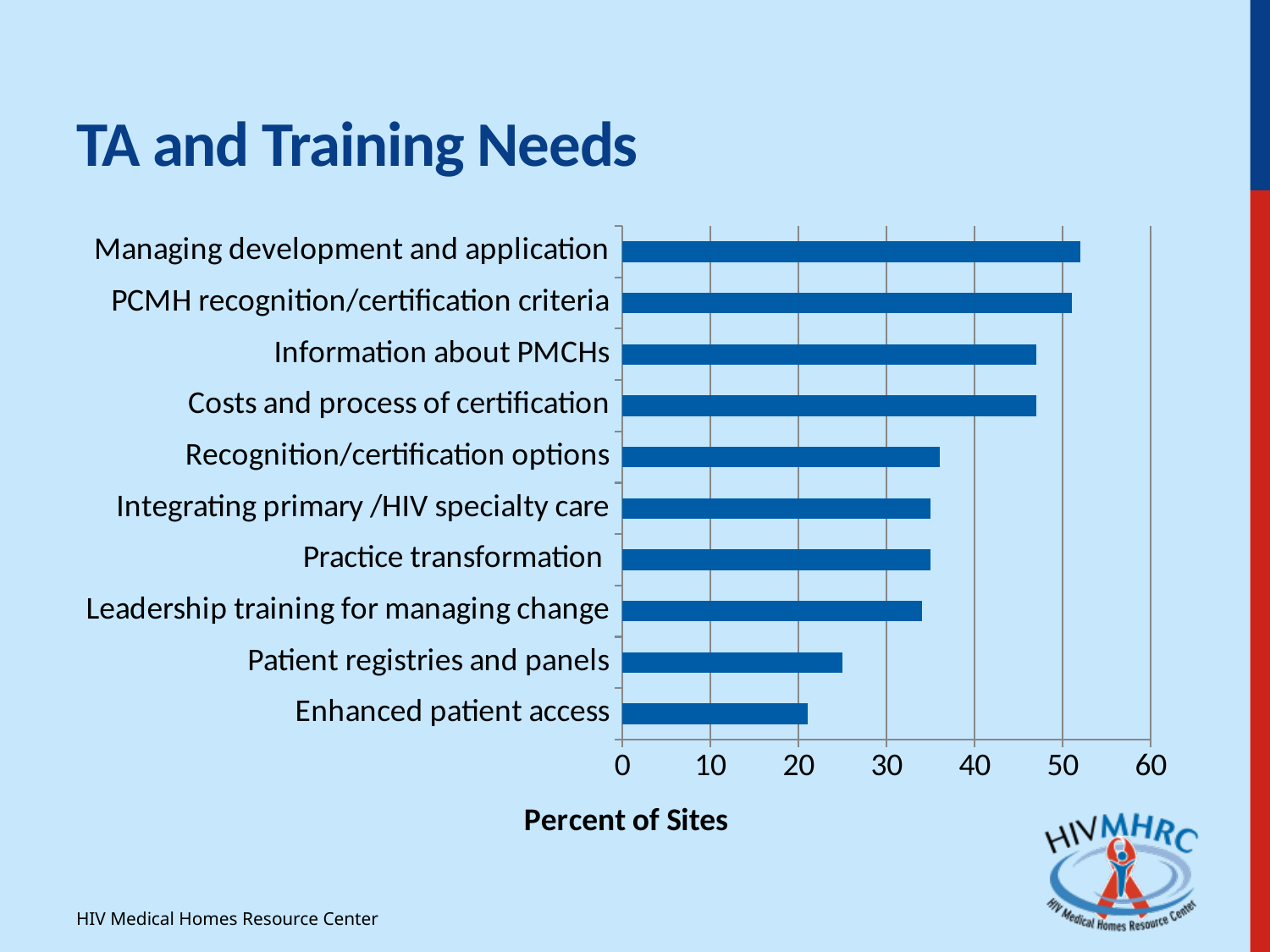
Which is larger: the value for Information about PMCHs or the value for Recognition/certification options? Information about PMCHs Is the value for Recognition/certification options greater or less than 30? greater Is the value for Patient registries and panels greater or less than 30? less Are the bars ordered from longest at the top to shortest at the bottom? yes Is the value for Practice transformation greater or less than 40? less Which category has the lowest percent of sites? Enhanced patient access Which is larger: the value for Patient registries and panels or the value for Enhanced patient access? Patient registries and panels What kind of chart is shown on the slide? bar chart What is the label on the horizontal axis of the chart? Percent of Sites How many categories (bars) does the chart show? 10